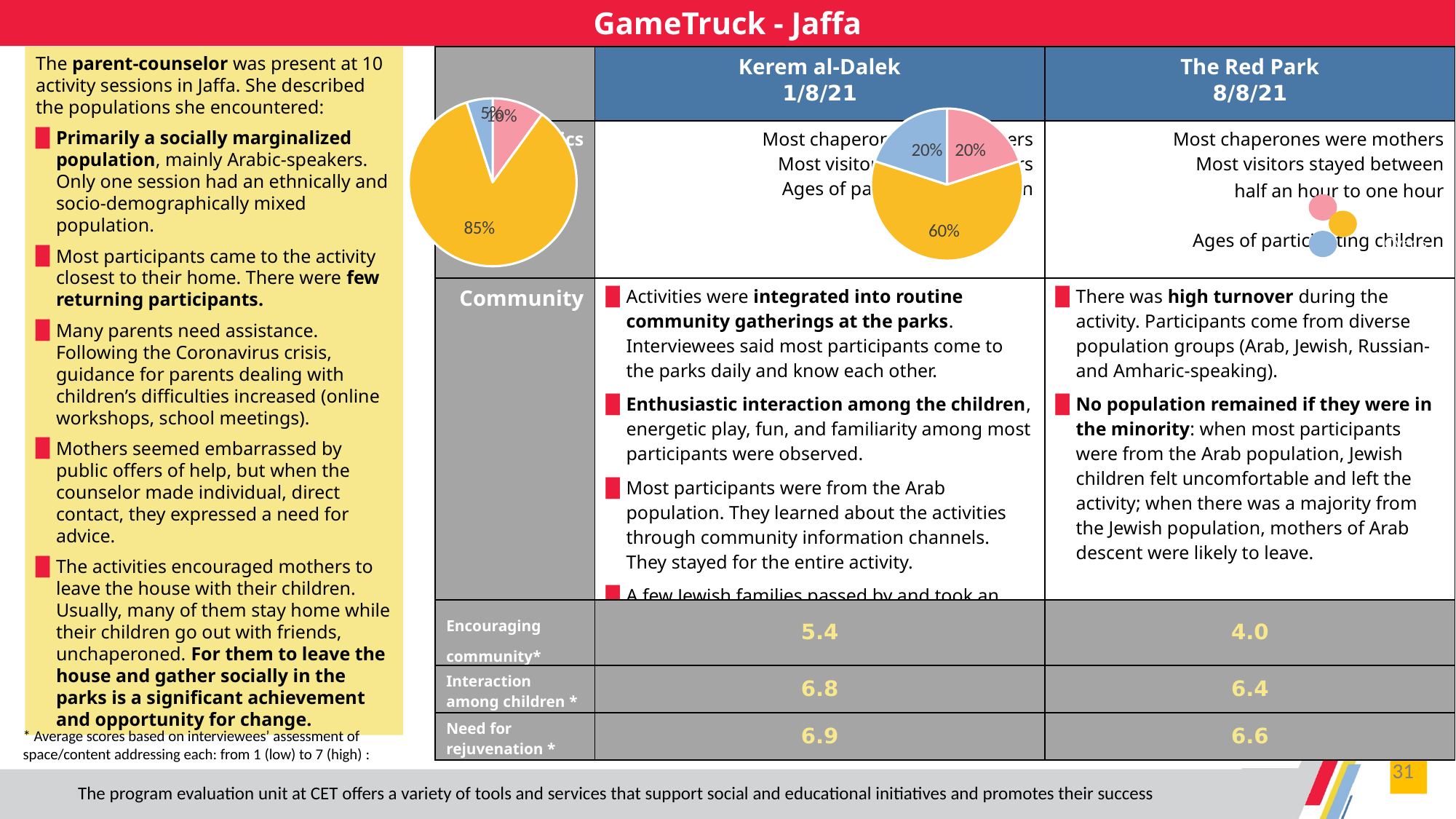
In the pie chart in the Kerem al-Dalek column, what share does the blue slice represent? 20% In the pie chart on the left side of the table, what share does the yellow slice represent? 85% In the pie chart in the Kerem al-Dalek column, which slice is larger, the yellow one or the blue one? Yellow What kind of chart is shown in the Kerem al-Dalek column? Pie chart In the pie chart in the Kerem al-Dalek column, what is the difference between the yellow slice and the pink slice? 40 percentage points How many slices does the pie chart on the left side of the table have? 3 In the pie chart in the Kerem al-Dalek column, what share does the pink slice represent? 20% In the pie chart on the left side of the table, what is the value of the largest slice? 85% How many slices does the pie chart in the Kerem al-Dalek column have? 3 In the pie chart on the left side of the table, what colour is the largest slice? Yellow In the pie chart in the Kerem al-Dalek column, what is the value of the largest slice? 60% In the pie chart in the Kerem al-Dalek column, what is the combined share of the blue and pink slices? 40%